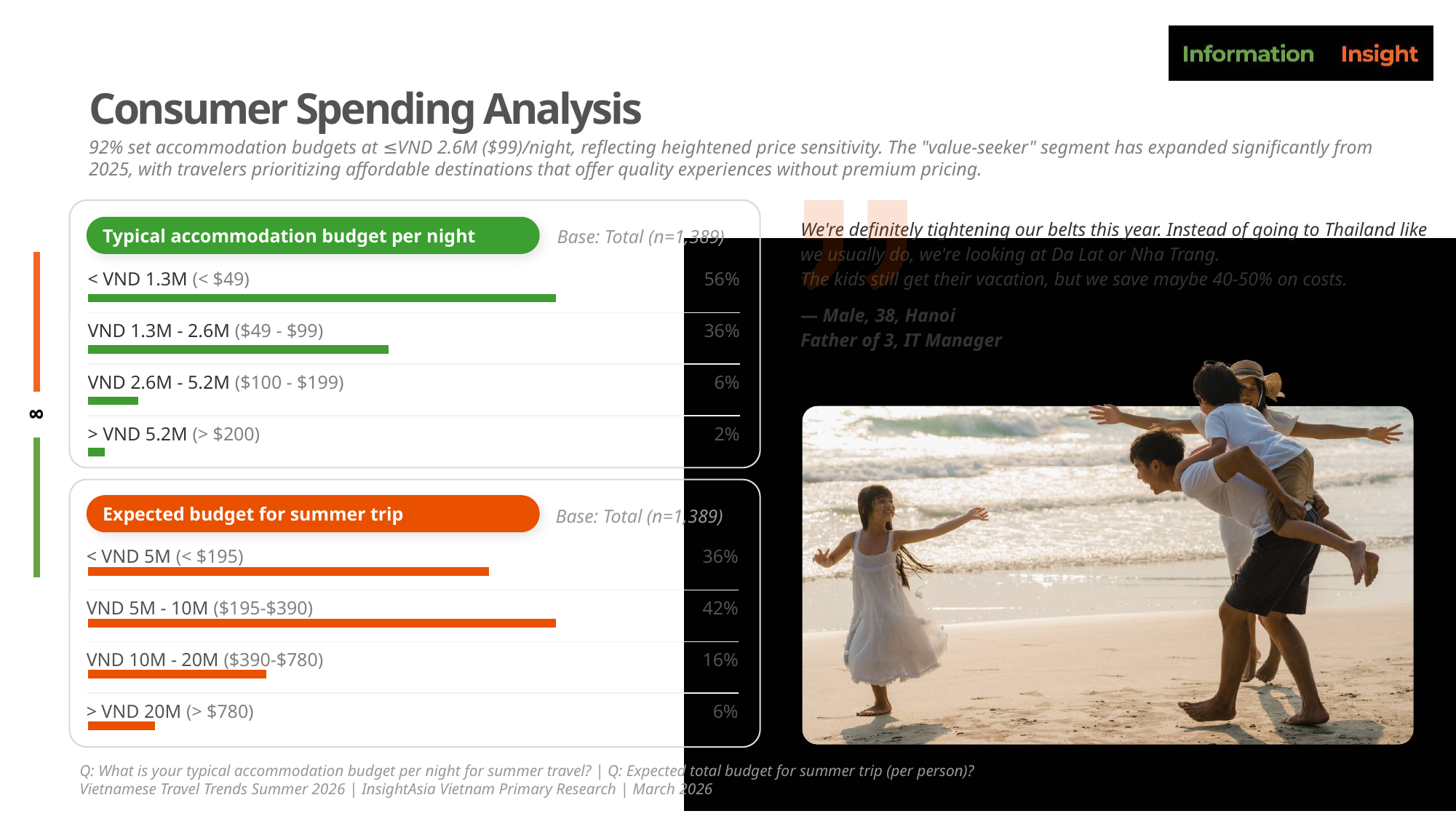
In the 'Expected budget for summer trip' chart, what is the difference between the VND 5M - 10M and VND 10M - 20M values? 26 percentage points In the 'Typical accommodation budget per night' chart, what is the value for VND 1.3M - 2.6M ($49 - $99)? 36% In the 'Typical accommodation budget per night' chart, what percentage of respondents chose < VND 1.3M (< $49)? 56% In the 'Typical accommodation budget per night' chart, which category has the lowest value? > VND 5.2M (> $200) In the 'Expected budget for summer trip' chart, which category has the highest value? VND 5M - 10M ($195-$390) What is the base sample size (n) shown for the 'Expected budget for summer trip' chart? n=1,389 In the 'Typical accommodation budget per night' chart, how many budget categories are shown? 4 In the 'Expected budget for summer trip' chart, what is the value for > VND 20M (> $780)? 6% In the 'Typical accommodation budget per night' chart, what is the difference between the < VND 1.3M and VND 1.3M - 2.6M values? 20 percentage points What type of chart is used for the 'Typical accommodation budget per night' data? Bar chart In the 'Expected budget for summer trip' chart, what is the value for VND 5M - 10M ($195-$390)? 42% In the 'Expected budget for summer trip' chart, which is larger: < VND 5M or VND 10M - 20M? < VND 5M